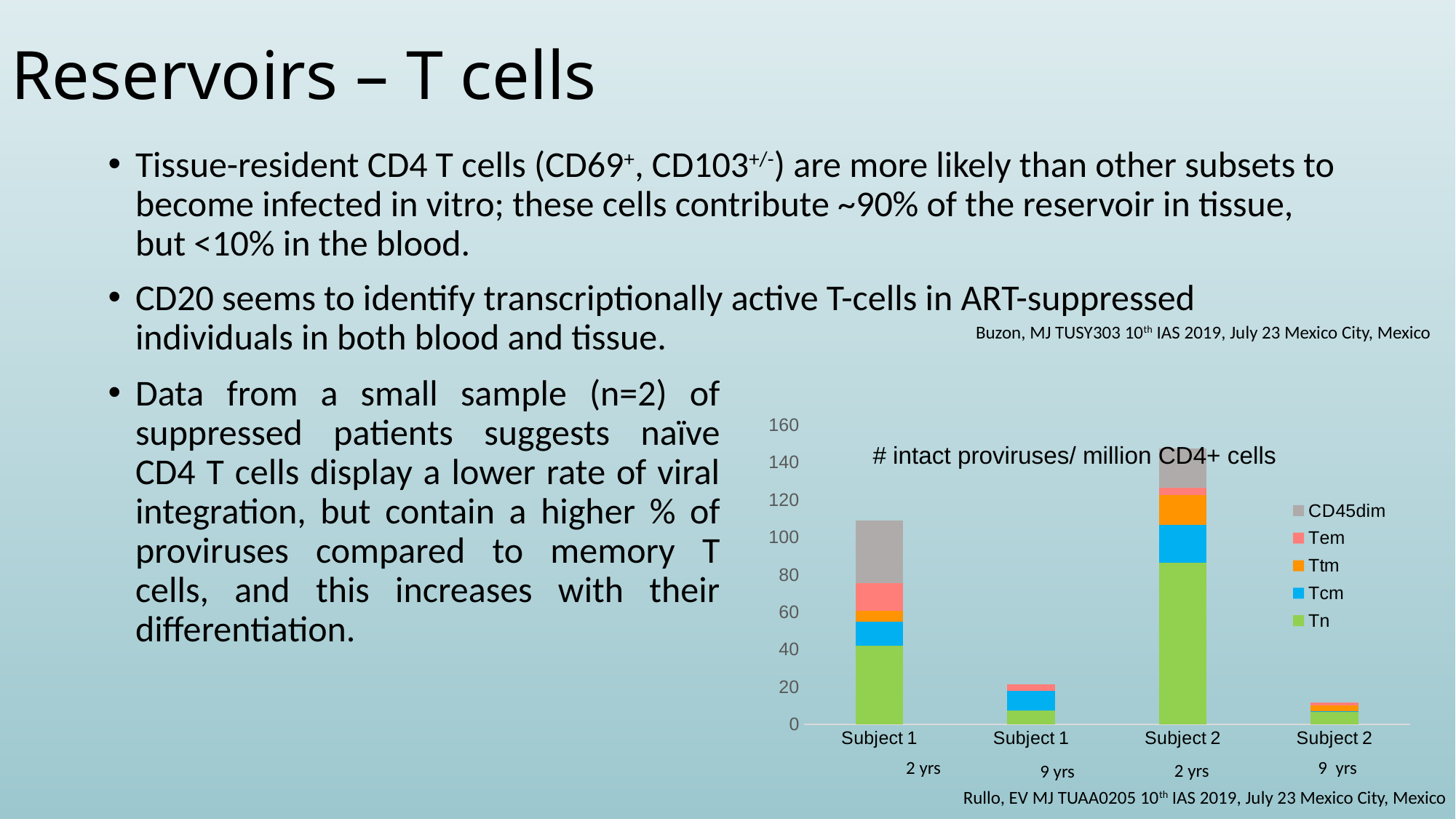
How many bars are plotted in the chart? 4 Which bar has the lowest total in the chart? Subject 2, 9 yrs Is the total for Subject 2 at 9 yrs greater or less than 20? less Which bar has the highest total in the chart? Subject 2, 2 yrs Is the total for Subject 1 at 2 yrs greater or less than 100? greater What is the title of the chart? # intact proviruses/ million CD4+ cells Is the total for Subject 1 at 9 yrs greater or less than 40? less What kind of chart is shown on the slide? stacked bar chart How many series does the chart legend list? 5 Which series is shown in green in the chart legend? Tn Which is larger: the total for Subject 1 at 2 yrs or the total for Subject 1 at 9 yrs? Subject 1 at 2 yrs